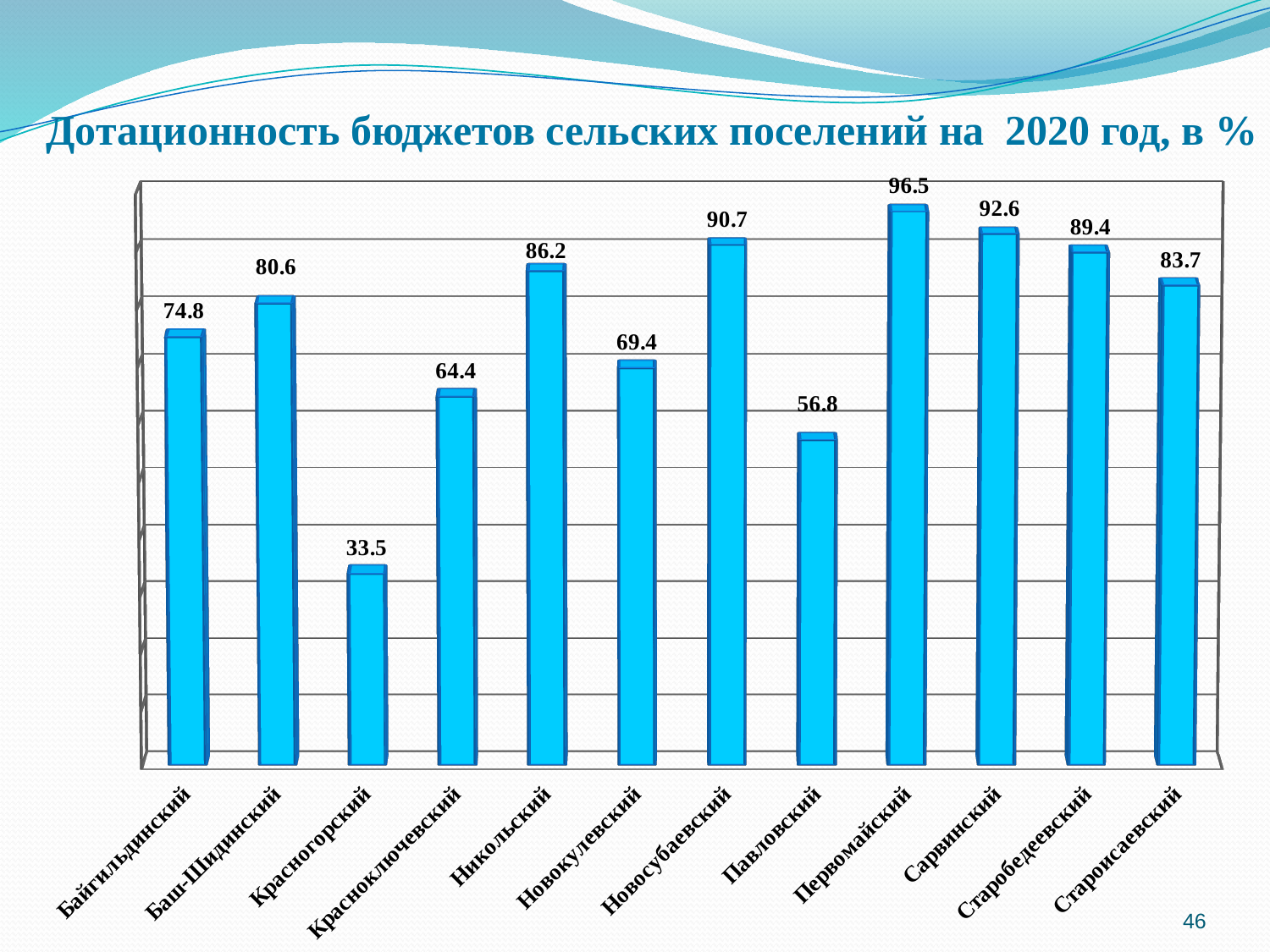
What is the value for Первомайский? 96.5 What is the value for Старобедеевский? 89.4 What is the value for Красногорский? 33.5 What kind of chart is shown on the slide? Bar chart What is the difference between the values for Сарвинский and Никольский? 6.4 Which category has the lowest value? Красногорский How many categories are shown on the chart? 12 Which is larger, the value for Баш-Шидинский or the value for Новокулевский? Баш-Шидинский What is the value for Павловский? 56.8 What is the difference between the values for Первомайский and Красногорский? 63.0 Which category has the highest value? Первомайский What is the title of the chart? Дотационность бюджетов сельских поселений на 2020 год, в %